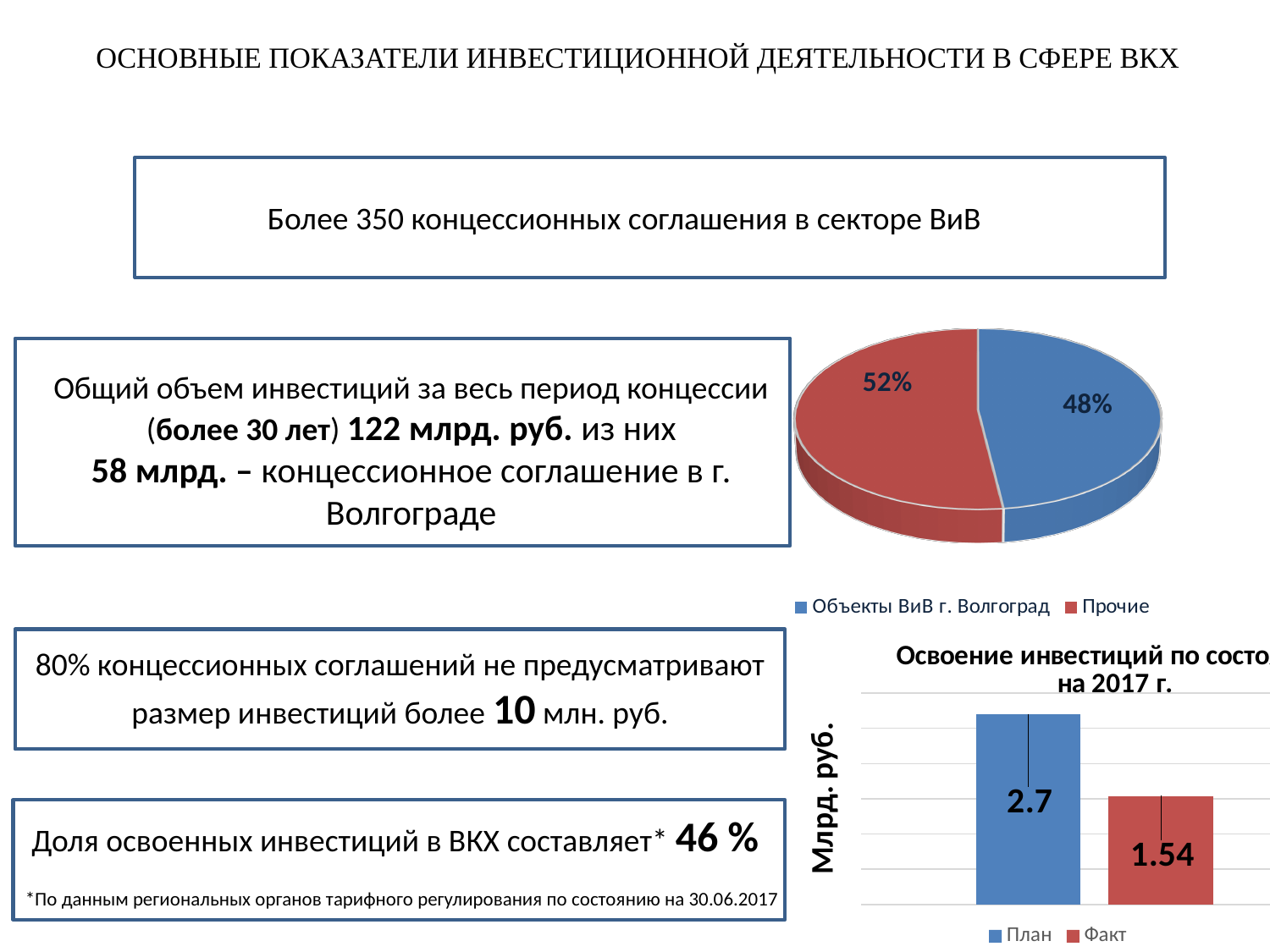
In the bar chart at the bottom right, which bar is higher: План or Факт? План In the pie chart, how many slices are there? 2 In the pie chart, what share is labelled for Объекты ВиВ г. Волгоград? 48% In the bar chart at the bottom right, how many series does the legend list? 2 In the bar chart at the bottom right, what is the value for Факт? 1.54 What type of chart is shown at the bottom right of the slide? Bar chart In the pie chart, what colour is the Прочие slice? Red In the bar chart at the bottom right, what is the value for План? 2.7 In the pie chart, what share is labelled for Прочие? 52% In the bar chart at the bottom right, what is the difference between План and Факт? 1.16 In the pie chart, which slice is larger: Объекты ВиВ г. Волгоград or Прочие? Прочие In the bar chart at the bottom right, what is the y-axis label? Млрд. руб.